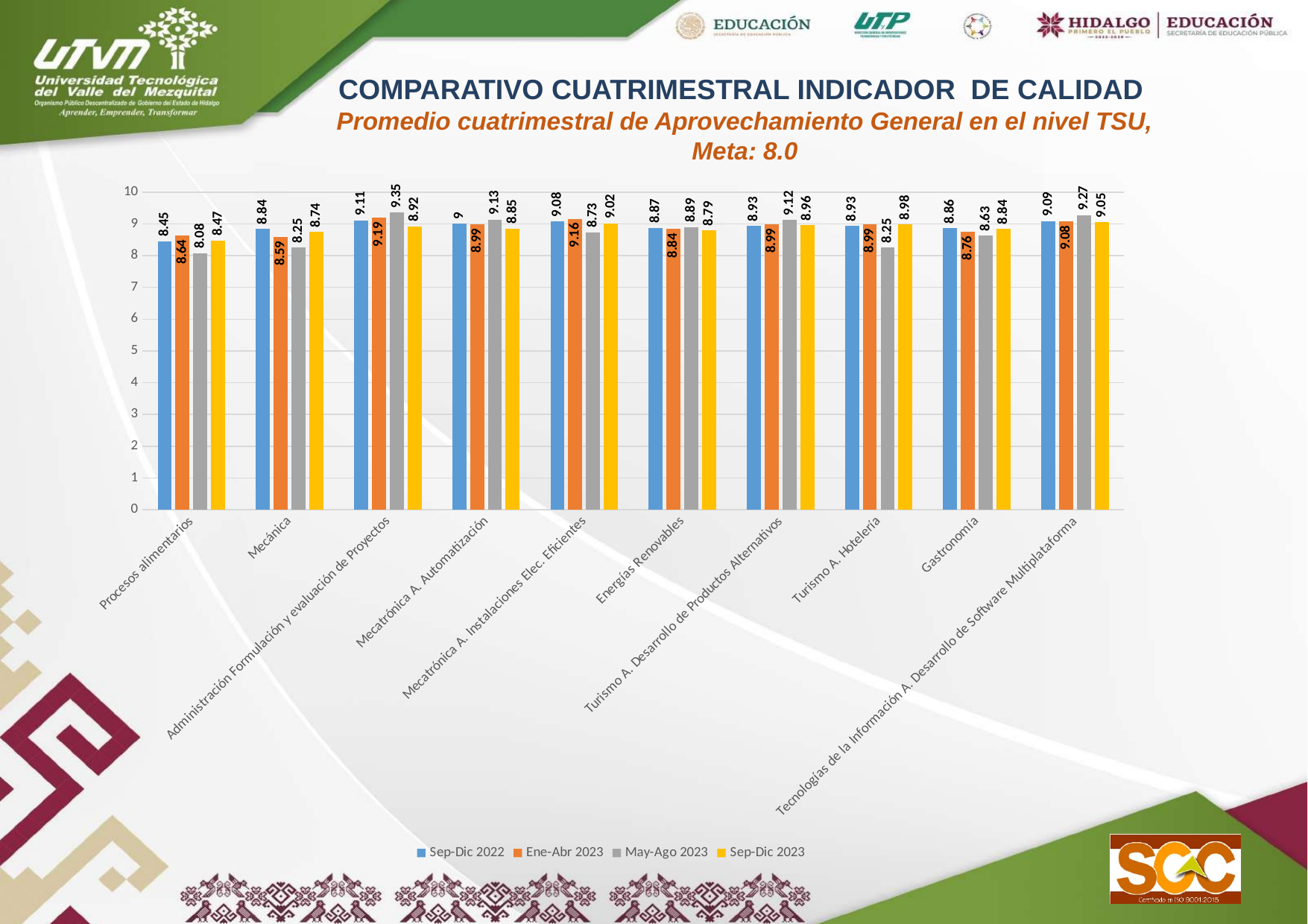
What type of chart is shown on the slide? bar chart Which category has the lowest Sep-Dic 2022 value? Procesos alimentarios Is the May-Ago 2023 value for Procesos alimentarios greater or less than 9? less How many program categories are shown on the x axis? 10 What is the May-Ago 2023 value for Administración Formulación y evaluación de Proyectos? 9.35 What is the difference between the May-Ago 2023 and Sep-Dic 2023 values for Turismo A. Hotelería? 0.73 What is the Ene-Abr 2023 value for Mecánica? 8.59 Which category has the highest May-Ago 2023 value? Administración Formulación y evaluación de Proyectos How many series does the legend list? 4 What target (Meta) is stated in the chart subtitle? 8.0 Which is larger for Energías Renovables: the Sep-Dic 2022 value or the Sep-Dic 2023 value? Sep-Dic 2022 What is the Sep-Dic 2023 value for Gastronomía? 8.84